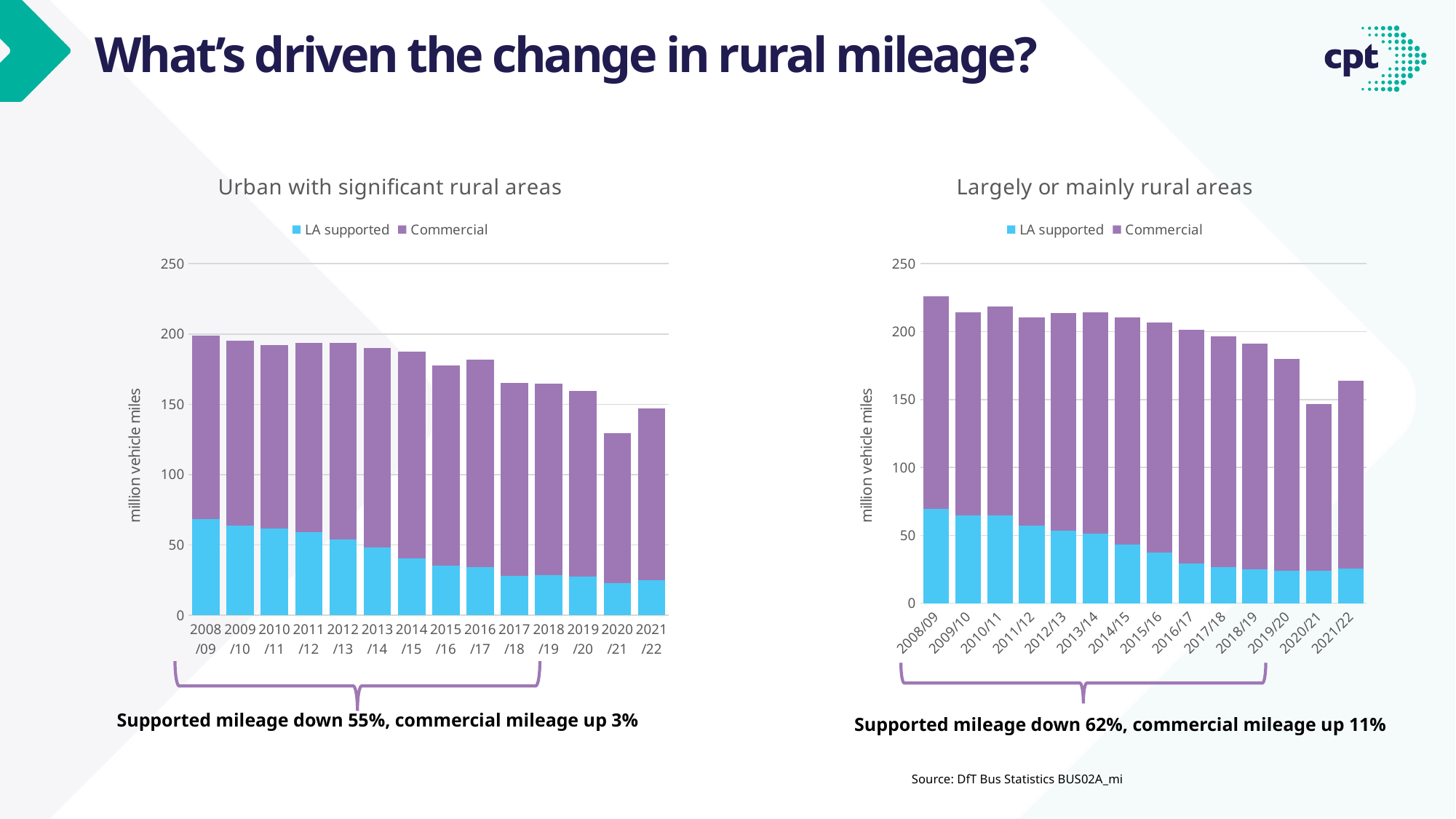
On the 'Urban with significant rural areas' chart, do the total bars generally rise or fall from 2008/09 to 2021/22? Fall On the 'Largely or mainly rural areas' chart, which year has the lowest total bar? 2020/21 How many series does the legend list on the 'Largely or mainly rural areas' chart? 2 On the 'Urban with significant rural areas' chart, is the total bar for 2020/21 greater or less than 150? less On the 'Urban with significant rural areas' chart, which year has the lowest total bar? 2020/21 On the 'Largely or mainly rural areas' chart, is the total bar for 2008/09 greater or less than 200? greater On the 'Largely or mainly rural areas' chart, is the LA supported value larger in 2008/09 or 2021/22? 2008/09 How many years are shown on the x axis of the 'Urban with significant rural areas' chart? 14 On the 'Largely or mainly rural areas' chart, which year has the highest total bar? 2008/09 What kind of chart is the 'Urban with significant rural areas' chart? Stacked bar chart On the 'Urban with significant rural areas' chart, is the LA supported value for 2008/09 greater or less than 50? greater